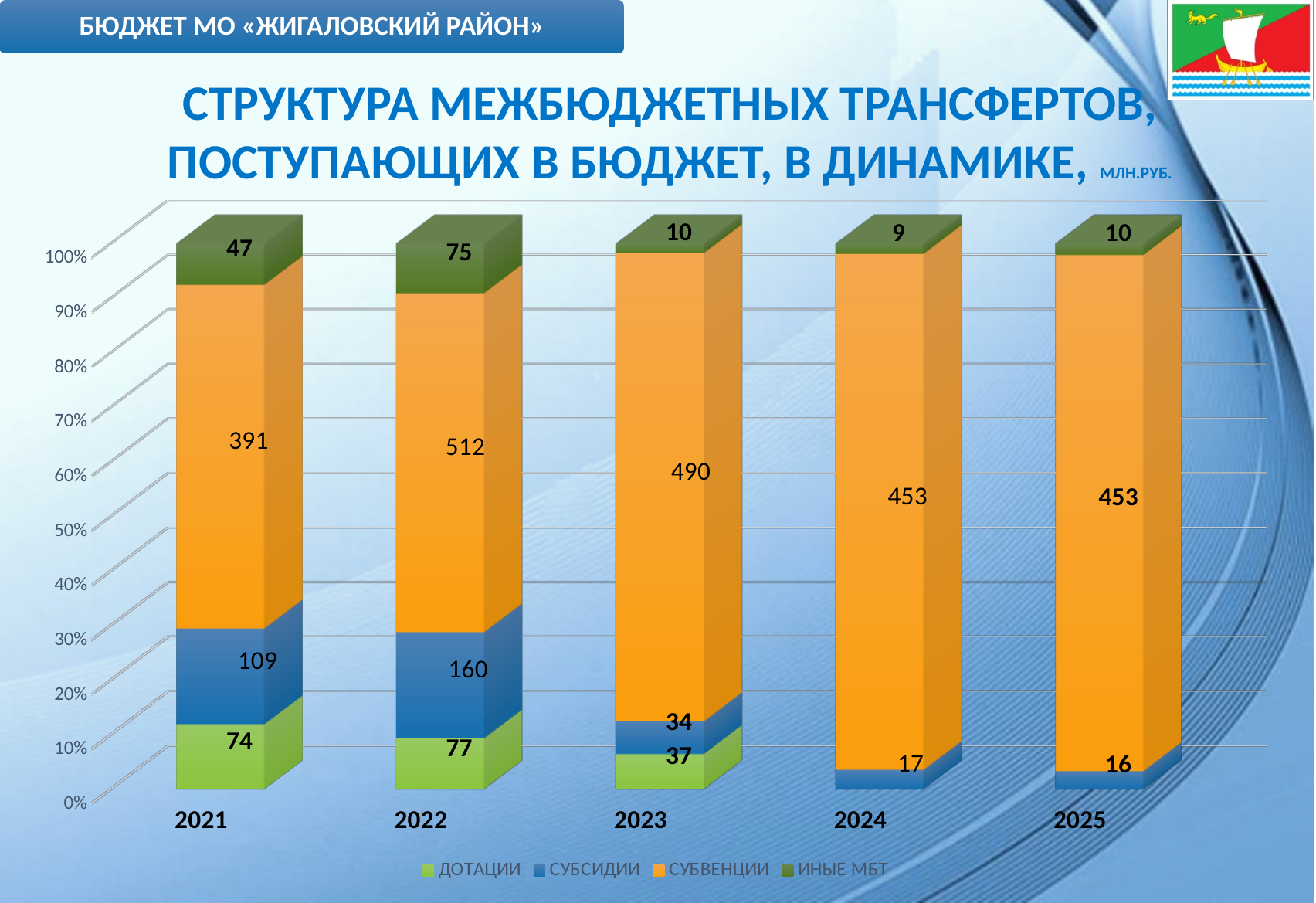
What is the value of СУБСИДИИ for 2021? 109 How many years are shown on the x axis? 5 What is the value of ИНЫЕ МБТ for 2024? 9 In which year is the value of СУБСИДИИ the lowest? 2025 How many series does the legend list? 4 What is the value of СУБВЕНЦИИ for 2022? 512 Which is larger: ИНЫЕ МБТ in 2022 or ИНЫЕ МБТ in 2021? 2022 What kind of chart is shown on the slide? Stacked bar chart In which year is the value of СУБВЕНЦИИ the highest? 2022 What is the difference between the СУБСИДИИ values for 2022 and 2021? 51 What is the total of the stacked bar for 2023? 571 What is the value of ДОТАЦИИ for 2023? 37